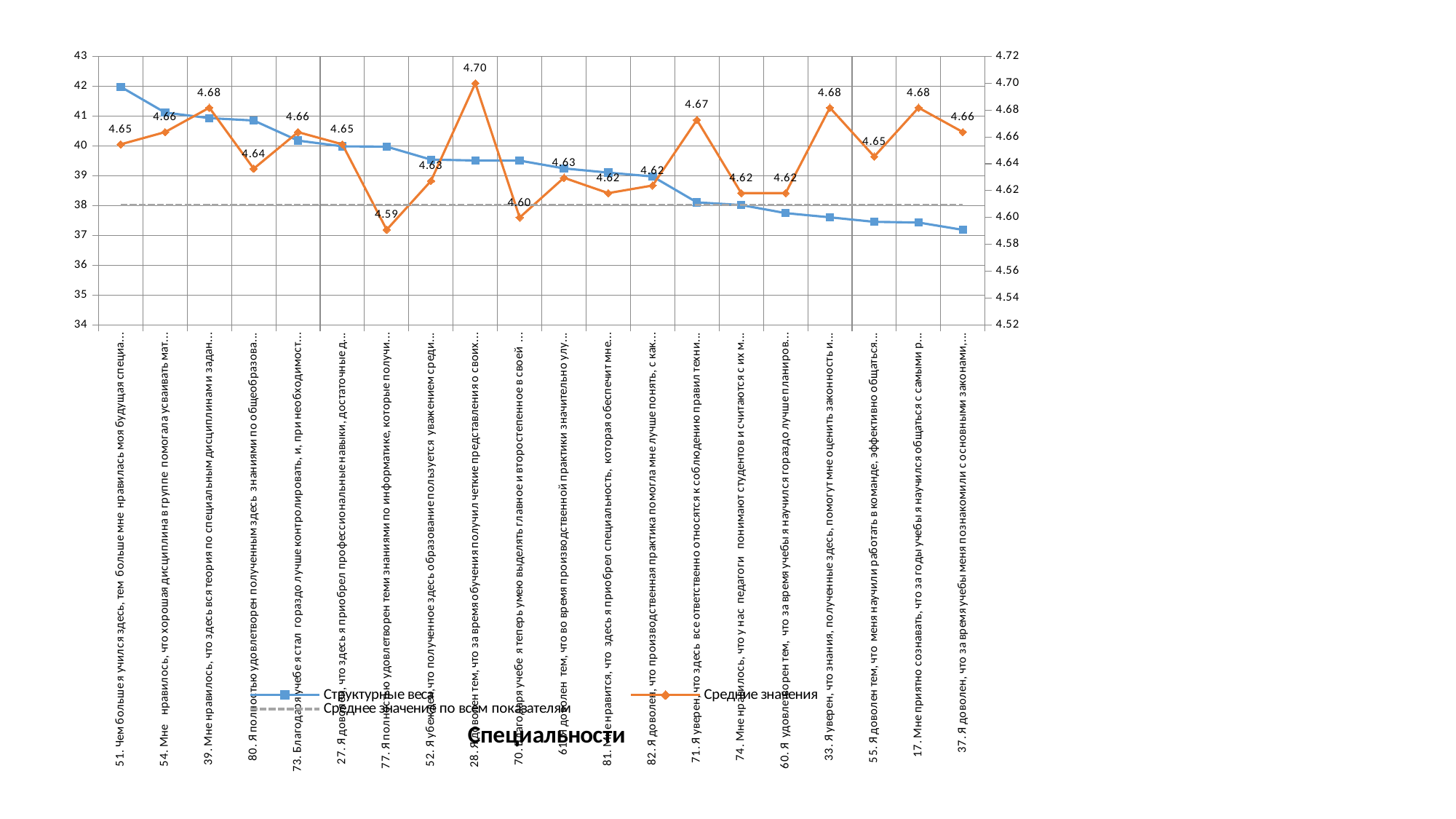
How many categories are plotted along the x axis? 20 What is the value of the 'Средние значения' series for the category starting with '71.'? 4.67 Is the 'Структурные веса' value for the first category (starting with '51.') greater or less than 41? greater What is the difference between the highest and lowest values of the 'Средние значения' series? 0.11 How many entries does the legend list? 3 Which category has the highest value in the 'Средние значения' series? 28. In the 'Средние значения' series, which category has the larger value: the one starting with '28.' or the one starting with '77.'? 28. What kind of chart is shown on the slide? line chart What is the value of the 'Средние значения' series for the category starting with '70.'? 4.60 Do the values of the 'Структурные веса' series rise or fall along the x axis? fall What is the value of the 'Средние значения' series for the category starting with '39.'? 4.68 Which category has the lowest value in the 'Средние значения' series? 77.